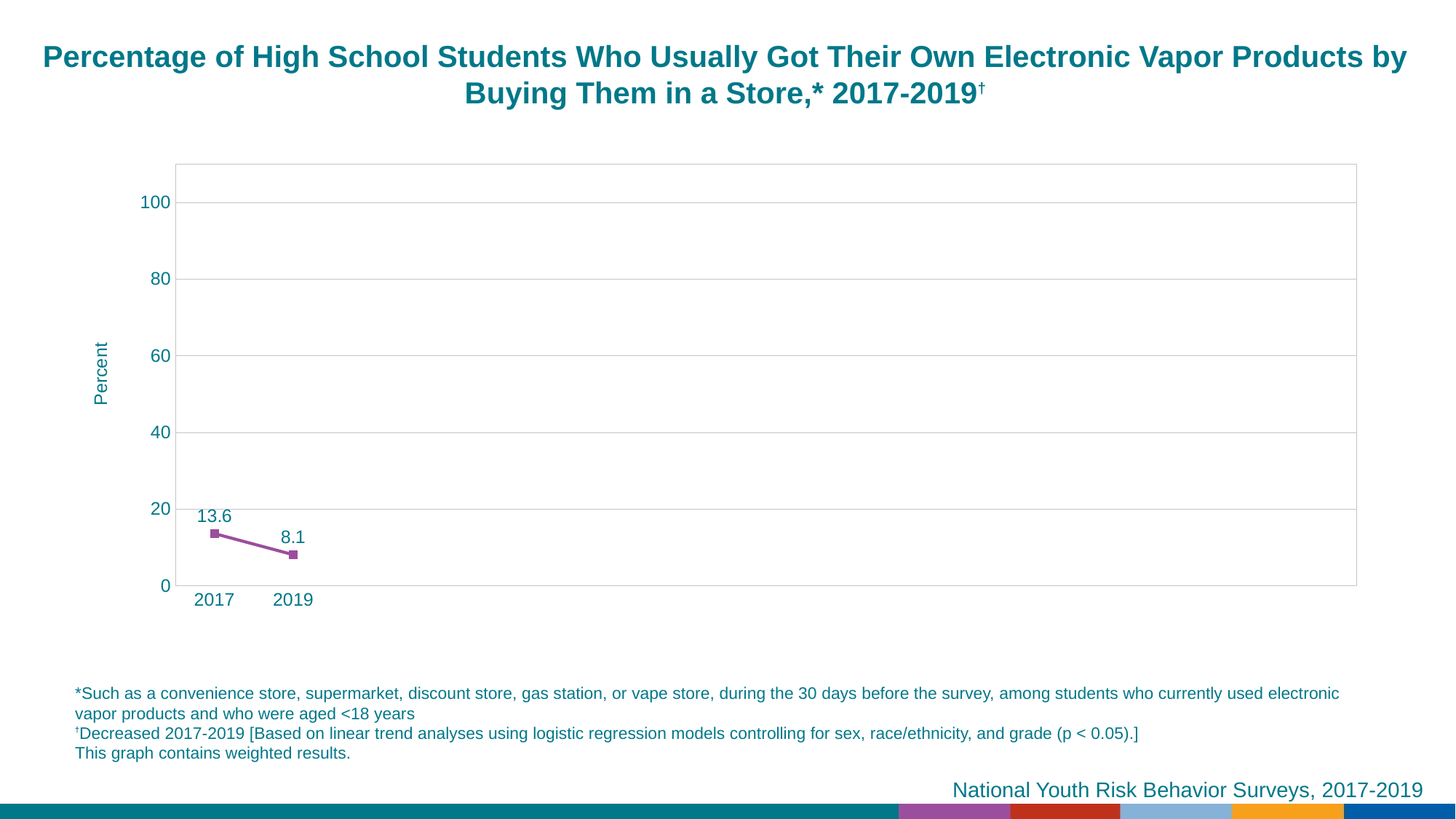
Do the values rise or fall from 2017 to 2019? fall Which is larger, the value for 2017 or the value for 2019? 2017 What is the value for 2017? 13.6 Which year has the lowest value? 2019 Which year has the highest value? 2017 What is the value for 2019? 8.1 What is the label on the y axis? Percent How many data points are plotted on the chart? 2 What is the maximum value shown on the y axis? 100 Is the value for 2017 greater or less than 20? less What is the difference between the 2017 and 2019 values? 5.5 What kind of chart is shown on the slide? line chart